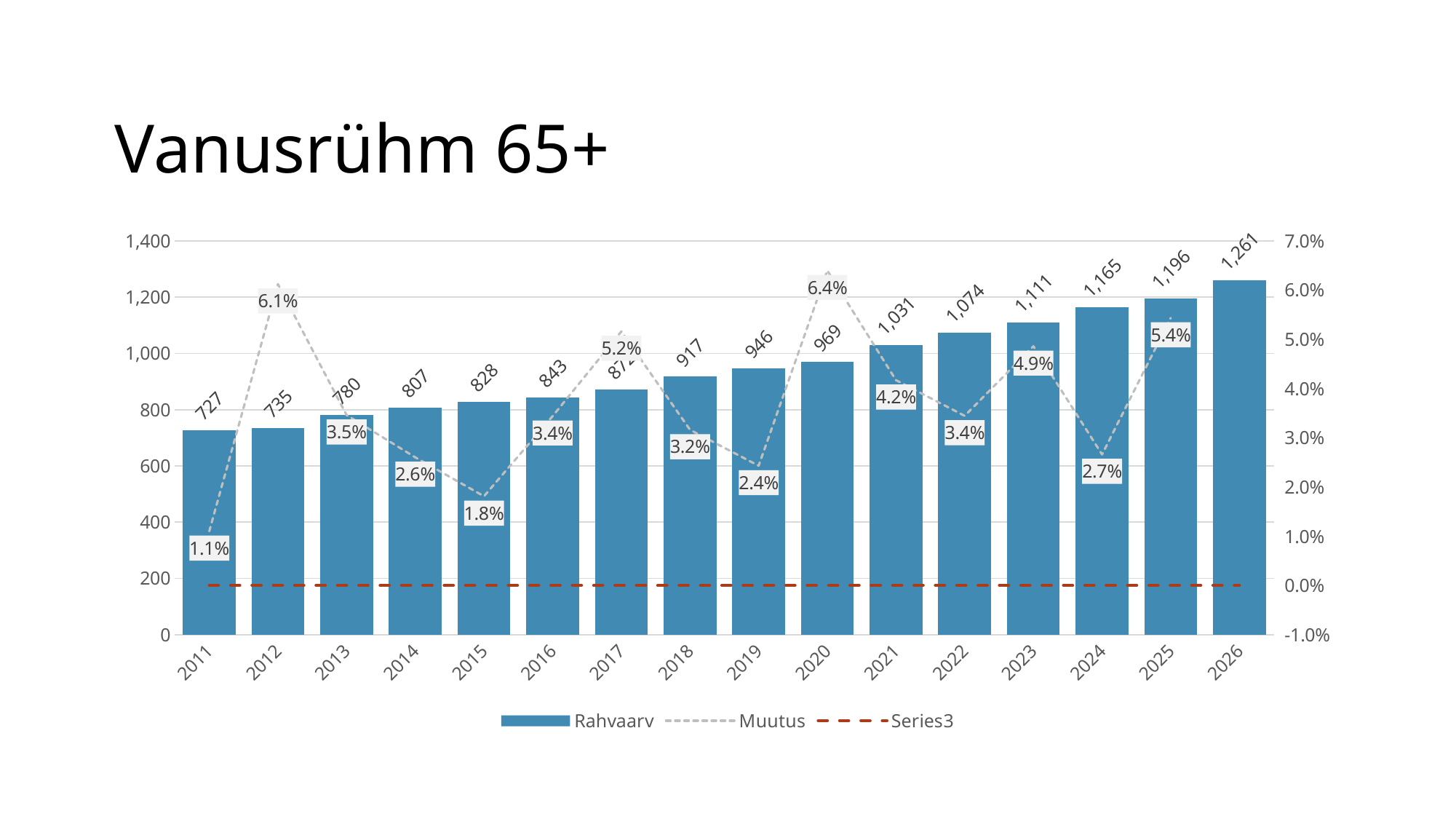
What is the Rahvaarv value for 2011? 727 Which year has the highest Rahvaarv value? 2026 What is the difference between the Rahvaarv values for 2026 and 2025? 65 Which year has the lowest Muutus value? 2011 What is the title of the slide? Vanusrühm 65+ What is the Muutus value for 2020? 6.4% What is the Rahvaarv value for 2026? 1,261 How many series does the legend list? 3 How many years are shown on the x axis? 16 What is the Muutus value for 2015? 1.8% Do the Rahvaarv bar values rise or fall from 2011 to 2026? rise Which is larger, the Muutus value for 2012 or for 2020? 2020